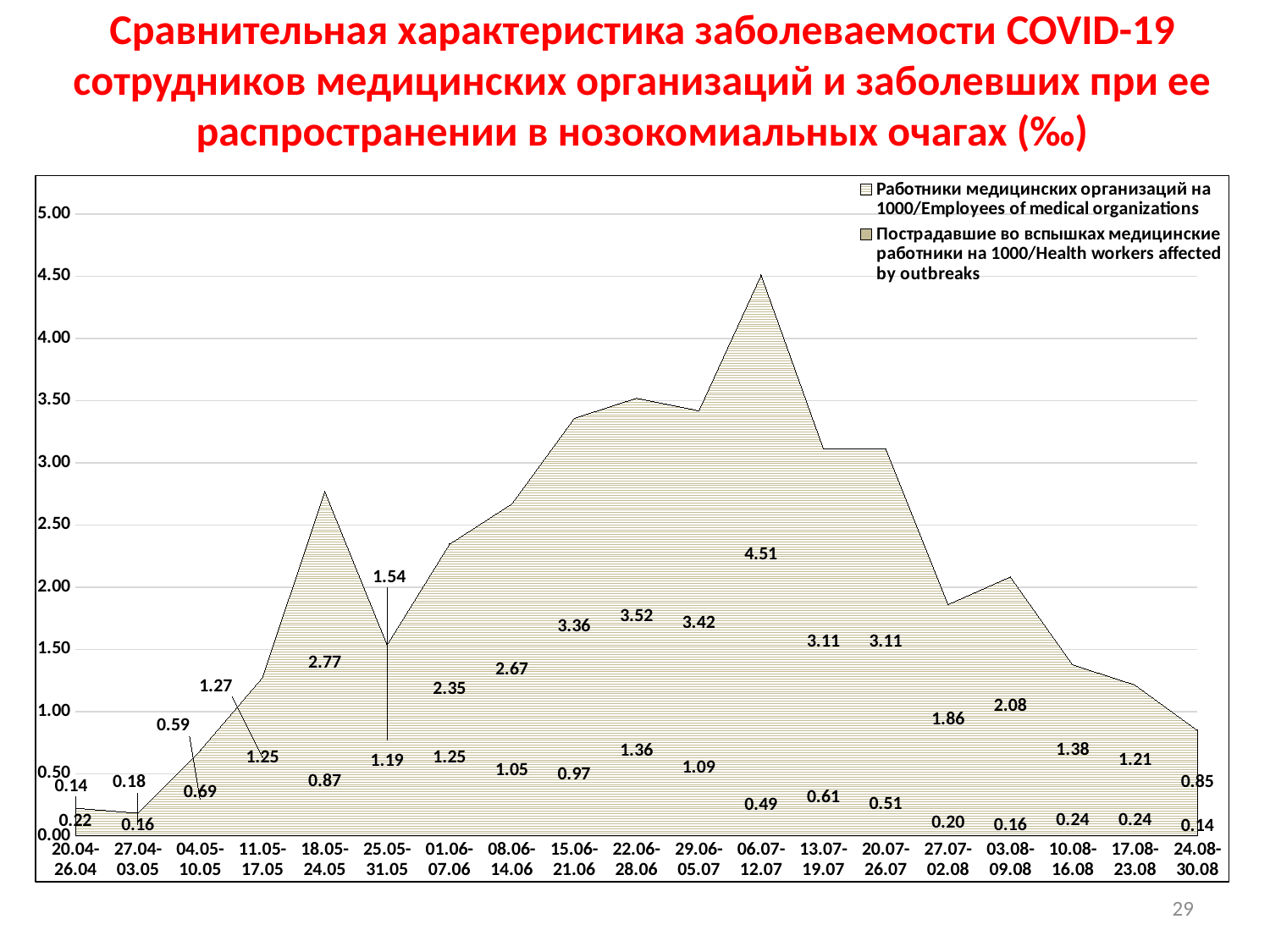
In which period does the Employees of medical organizations series reach its highest value? 06.07-12.07 What kind of chart is shown on the slide? Area chart For Employees of medical organizations, which period has the larger value: 18.05-24.05 or 25.05-31.05? 18.05-24.05 How many series does the legend list? 2 What is the value for Employees of medical organizations in the period 27.07-02.08? 1.86 What is the value for Employees of medical organizations in the period 06.07-12.07? 4.51 Does the Employees of medical organizations series rise or fall from 06.07-12.07 to 24.08-30.08? Fall How many weekly periods are shown on the x axis? 19 In the period 22.06-28.06, what is the difference between the Employees of medical organizations value and the Health workers affected by outbreaks value? 2.16 What is the value for Health workers affected by outbreaks in the period 03.08-09.08? 0.16 What is the difference between the Employees of medical organizations values for 06.07-12.07 and 29.06-05.07? 1.09 What is the value for Health workers affected by outbreaks in the period 22.06-28.06? 1.36